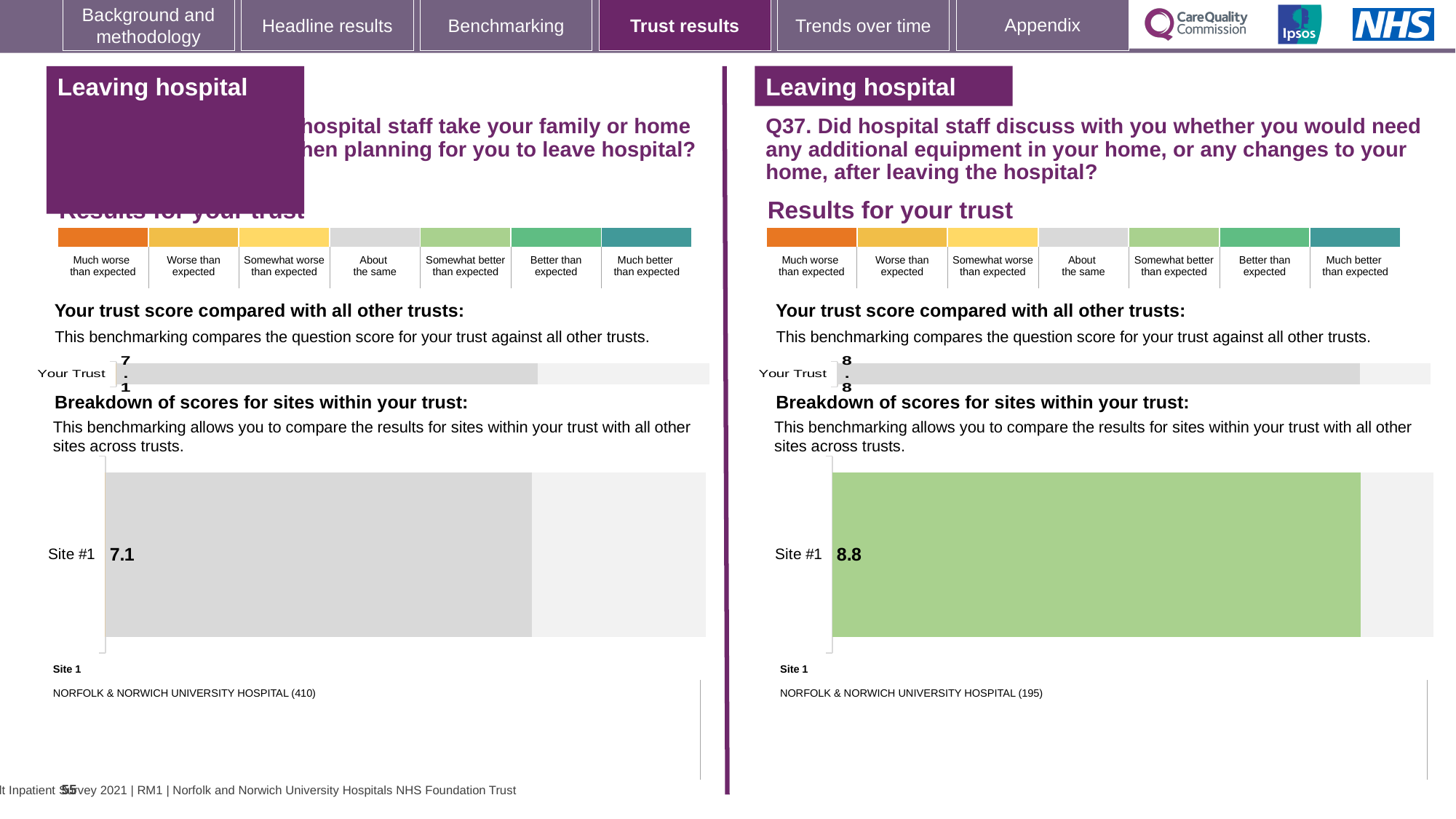
In the right-hand 'Your trust score compared with all other trusts' chart (Q37), what is the value shown for Your Trust? 8.8 In the left-hand 'Breakdown of scores for sites within your trust' chart, what is the score for Site #1? 7.1 How many sites are plotted in the left-hand 'Breakdown of scores for sites within your trust' chart? 1 Comparing the Site #1 bars in the left-hand and right-hand breakdown charts, which chart shows the larger score? The right-hand chart (Q37) In the right-hand 'Breakdown of scores for sites within your trust' chart (Q37), what is the score for Site #1? 8.8 What kind of chart is used for the 'Breakdown of scores for sites within your trust' on the right-hand side of the slide? Bar chart What colour is the Site #1 bar in the right-hand breakdown chart (Q37)? Green In the left-hand 'Your trust score compared with all other trusts' chart, what is the value shown for Your Trust? 7.1 According to the site key below the right-hand breakdown chart (Q37), which hospital is Site 1? NORFOLK & NORWICH UNIVERSITY HOSPITAL (195) What is the difference between the Site #1 score in the right-hand breakdown chart (Q37) and the Site #1 score in the left-hand breakdown chart? 1.7 How many sites are plotted in the right-hand 'Breakdown of scores for sites within your trust' chart (Q37)? 1